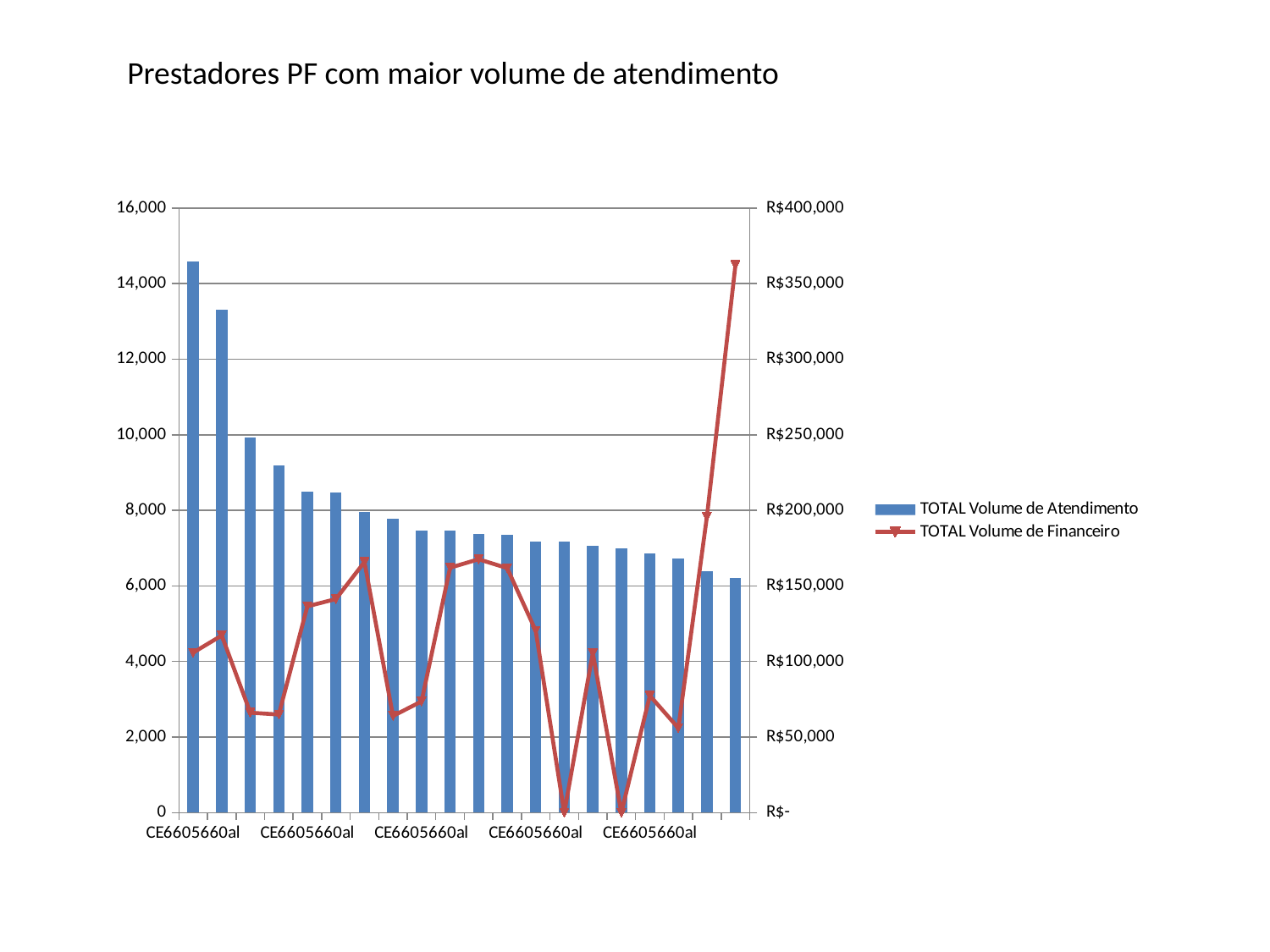
Which is larger for TOTAL Volume de Atendimento, the leftmost bar or the rightmost bar? The leftmost bar Is the value of the leftmost bar (TOTAL Volume de Atendimento) greater or less than 14,000? greater Which bar is the tallest for TOTAL Volume de Atendimento? The leftmost (first) bar Is the highest point of the TOTAL Volume de Financeiro line greater or less than R$350,000? greater What are the two series named in the legend? TOTAL Volume de Atendimento and TOTAL Volume de Financeiro Do the bars for TOTAL Volume de Atendimento rise or fall from left to right? Fall Which bar is the shortest for TOTAL Volume de Atendimento? The rightmost (last) bar Is the value of the rightmost bar (TOTAL Volume de Atendimento) greater or less than 8,000? less What is the title of the slide? Prestadores PF com maior volume de atendimento What kind of chart is shown on the slide? A combined bar and line chart How many series does the legend list? 2 Where does the TOTAL Volume de Financeiro line reach its highest value, at the left end or the right end of the chart? The right end